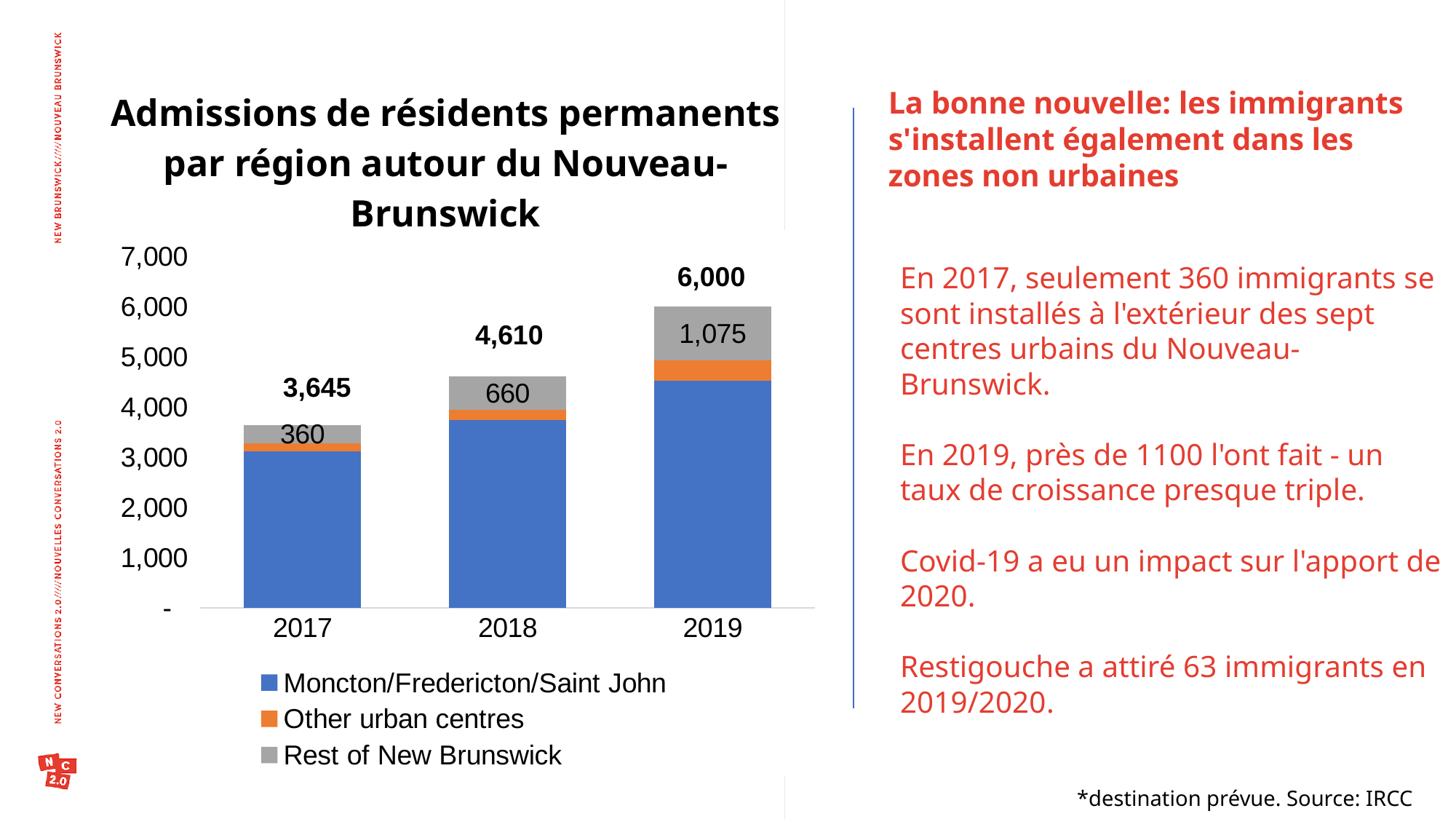
What kind of chart is shown on the slide? Stacked bar chart What value is labelled for Rest of New Brunswick in 2019? 1,075 What value is labelled for Rest of New Brunswick in 2018? 660 Do the total admissions rise or fall from 2017 to 2019? Rise What is the total number of permanent resident admissions shown for 2017? 3,645 By how much did the Rest of New Brunswick value increase from 2017 to 2019? 715 Is the value for Moncton/Fredericton/Saint John in 2019 greater or less than 4,000? greater Which year has the highest total admissions? 2019 What is the total number of permanent resident admissions shown for 2019? 6,000 What is the difference between the total admissions in 2019 and in 2017? 2,355 How many series does the legend list? 3 Which year has the lowest total admissions? 2017